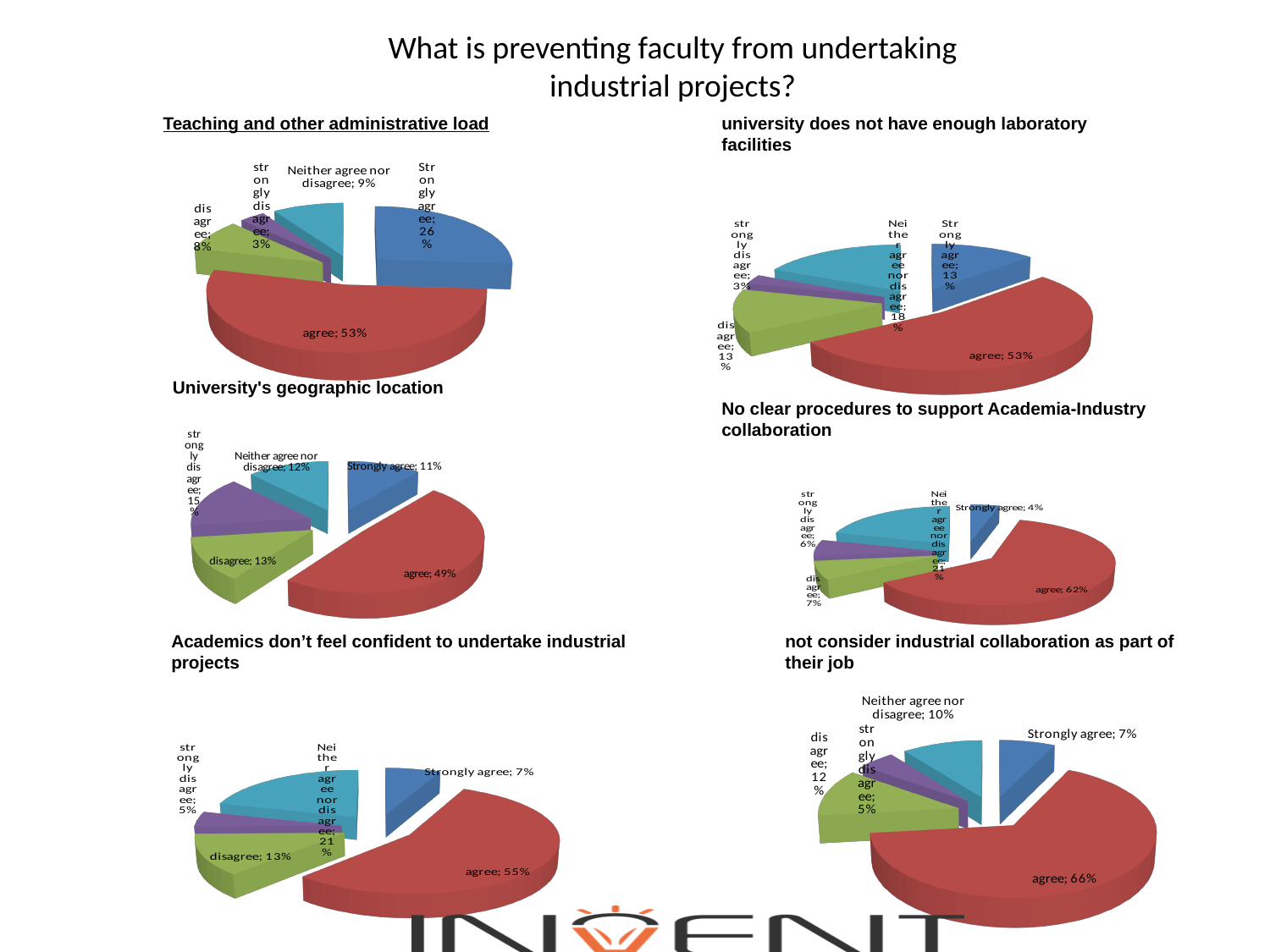
How many slices does the 'University's geographic location' pie chart have? 5 In the 'University's geographic location' chart, which response has the largest share? agree In the 'University's geographic location' chart, what is the difference between the 'agree' share and the 'strongly disagree' share? 34% In the 'No clear procedures to support Academia-Industry collaboration' chart, what percentage chose 'agree'? 62% In the 'No clear procedures to support Academia-Industry collaboration' chart, which response has the smallest share? Strongly agree In the 'Teaching and other administrative load' chart, what percentage of respondents chose 'agree'? 53% In the 'Academics don't feel confident to undertake industrial projects' chart, which is larger: 'disagree' or 'strongly disagree'? disagree In the 'not consider industrial collaboration as part of their job' chart, what is the combined share of 'Strongly agree' and 'agree'? 73% In the 'Teaching and other administrative load' chart, what percentage chose 'Strongly agree'? 26% In the 'university does not have enough laboratory facilities' chart, what percentage chose 'Neither agree nor disagree'? 18% What type of chart is used for 'Teaching and other administrative load'? Pie chart In the 'not consider industrial collaboration as part of their job' chart, what percentage chose 'agree'? 66%